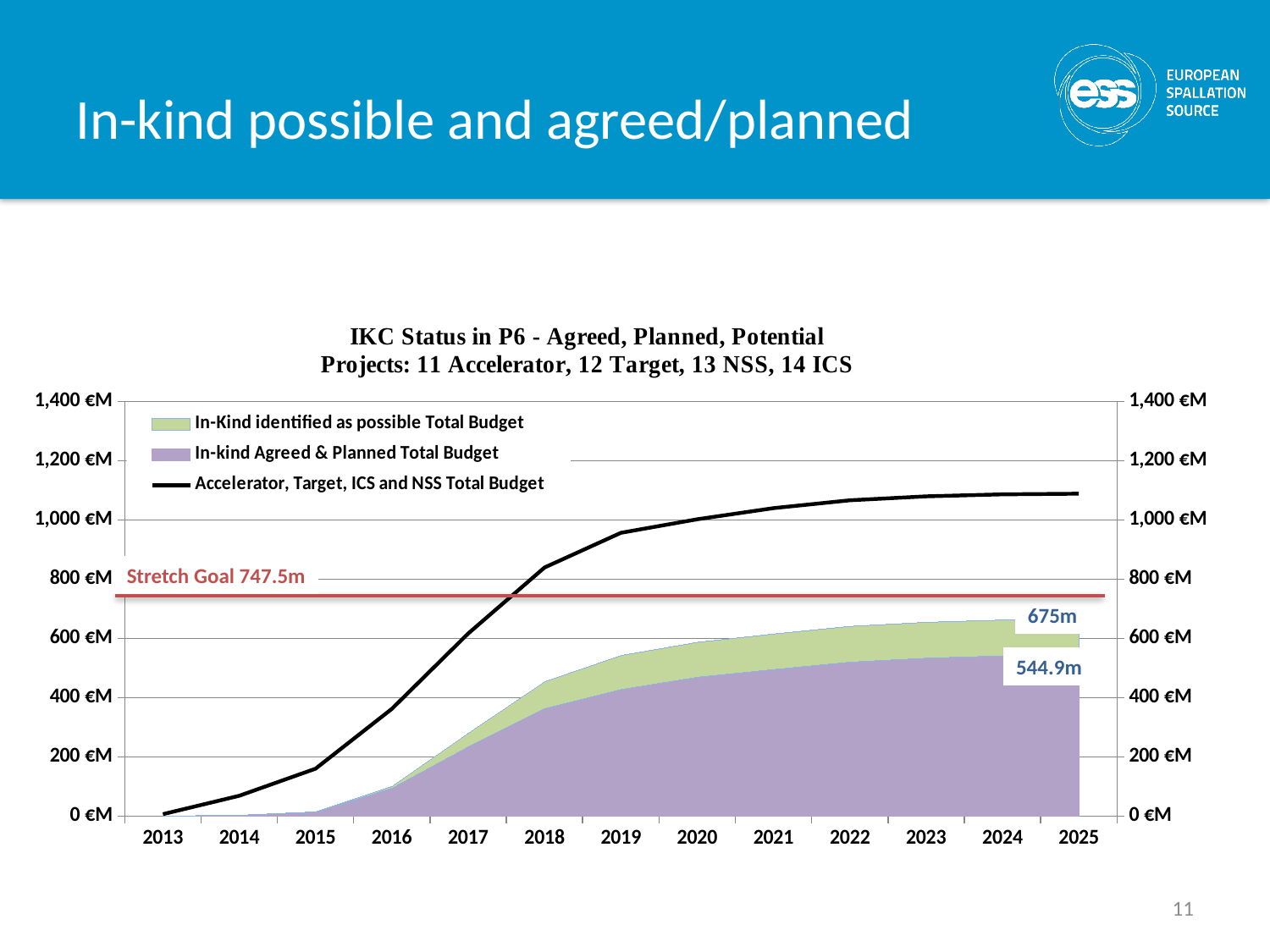
How many years are shown along the x axis? 13 What is the difference between the 675m label and the 544.9m label? 130.1m Is the Accelerator, Target, ICS and NSS Total Budget in 2025 greater or less than 1,000 €M? greater What value is labelled at the top of the In-Kind identified as possible area at the right end of the chart? 675m Is the Accelerator, Target, ICS and NSS Total Budget in 2017 greater or less than 800 €M? less How many series does the legend list? 3 What is the value of the Stretch Goal marked on the chart? 747.5m What value is labelled for the In-kind Agreed & Planned Total Budget at the right end of the chart? 544.9m Does the Accelerator, Target, ICS and NSS Total Budget line rise or fall from 2013 to 2025? Rise Is the In-kind Agreed & Planned Total Budget in 2019 greater or less than 600 €M? less What kind of chart is shown on the slide? Area chart with a line In 2018, which is larger: the Accelerator, Target, ICS and NSS Total Budget line or the In-Kind identified as possible Total Budget area? Accelerator, Target, ICS and NSS Total Budget